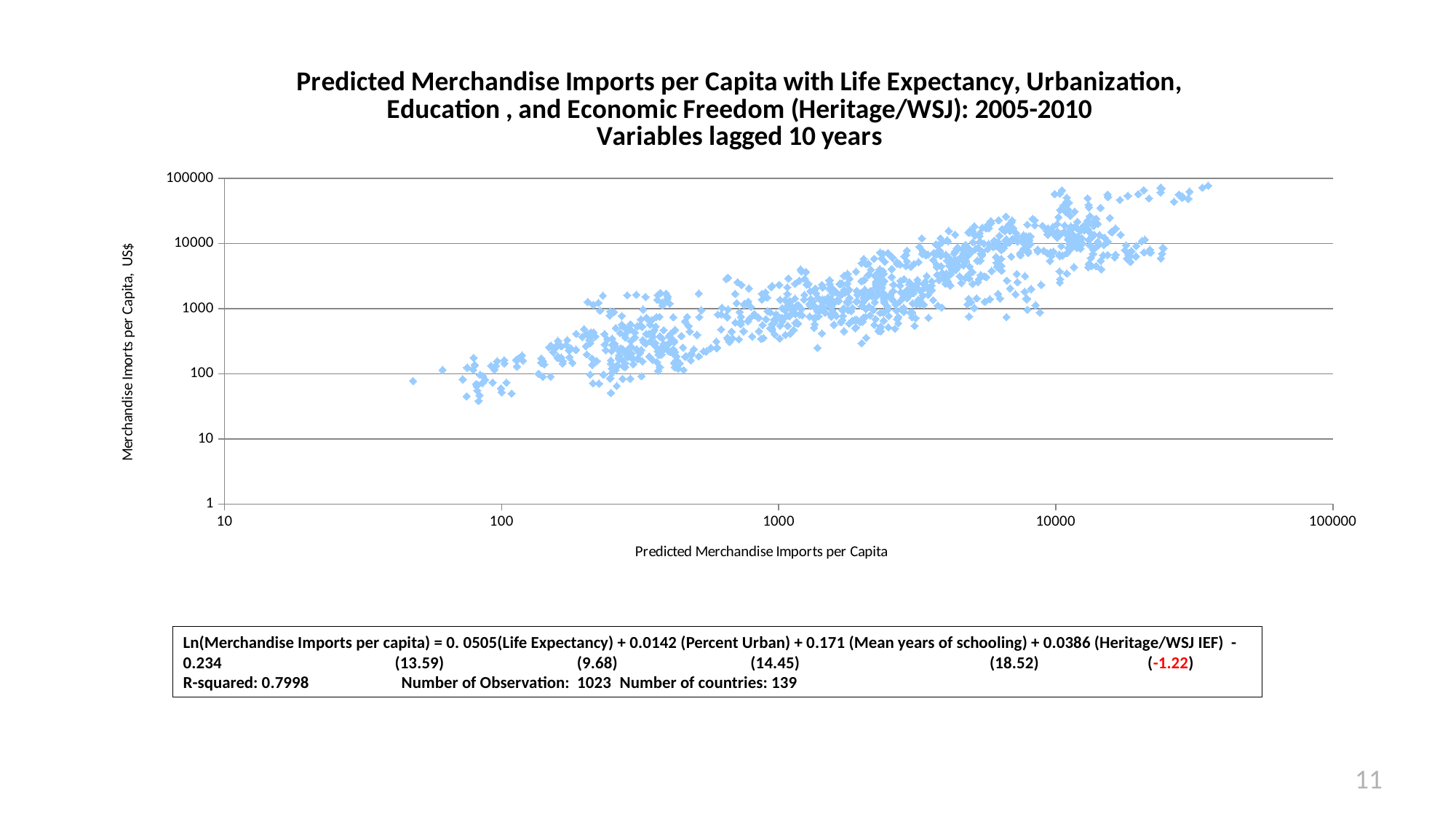
What kind of chart is shown on the slide? Scatter plot What is the label of the x axis of the chart? Predicted Merchandise Imports per Capita What is the lowest tick value shown on the x axis? 10 What is the highest tick value shown on the y axis? 100000 Do the plotted values generally rise or fall as Predicted Merchandise Imports per Capita increases along the x axis? Rise